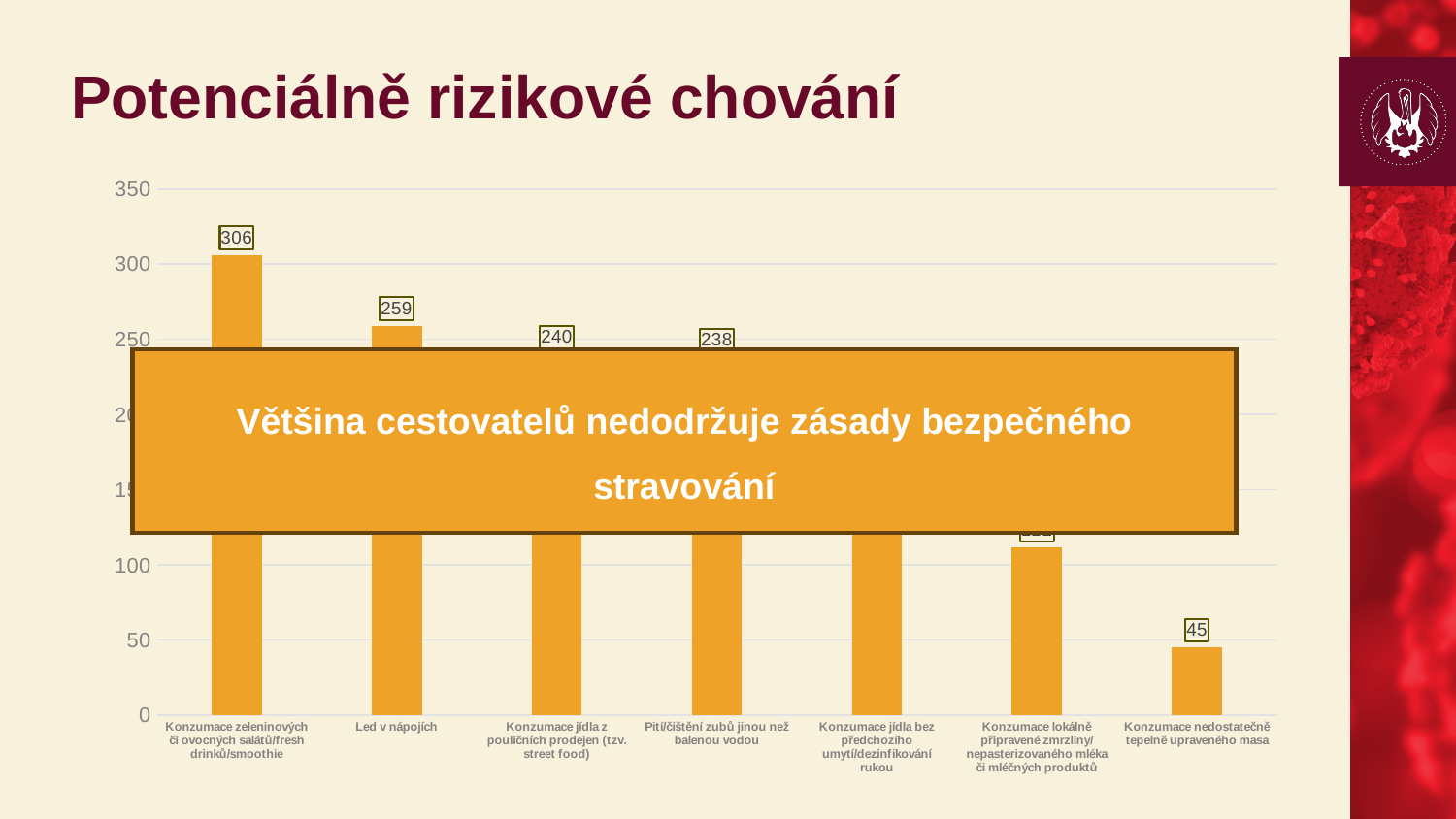
Which category has the lowest value? Konzumace nedostatečně tepelně upraveného masa Is the value for 'Konzumace lokálně připravené zmrzliny/nepasterizovaného mléka či mléčných produktů' greater or less than 150? less Which category has the highest value? Konzumace zeleninových či ovocných salátů/fresh drinků/smoothie What is the value for 'Pití/čištění zubů jinou než balenou vodou'? 238 What kind of chart is shown on the slide? bar chart What is the title of the slide? Potenciálně rizikové chování What is the value for 'Led v nápojích'? 259 What is the value for 'Konzumace zeleninových či ovocných salátů/fresh drinků/smoothie'? 306 What is the value for 'Konzumace nedostatečně tepelně upraveného masa'? 45 What is the difference between the values for 'Konzumace zeleninových či ovocných salátů/fresh drinků/smoothie' and 'Led v nápojích'? 47 How many categories are shown in the chart? 7 Which is larger: the value for 'Led v nápojích' or for 'Konzumace jídla z pouličních prodejen (tzv. street food)'? Led v nápojích